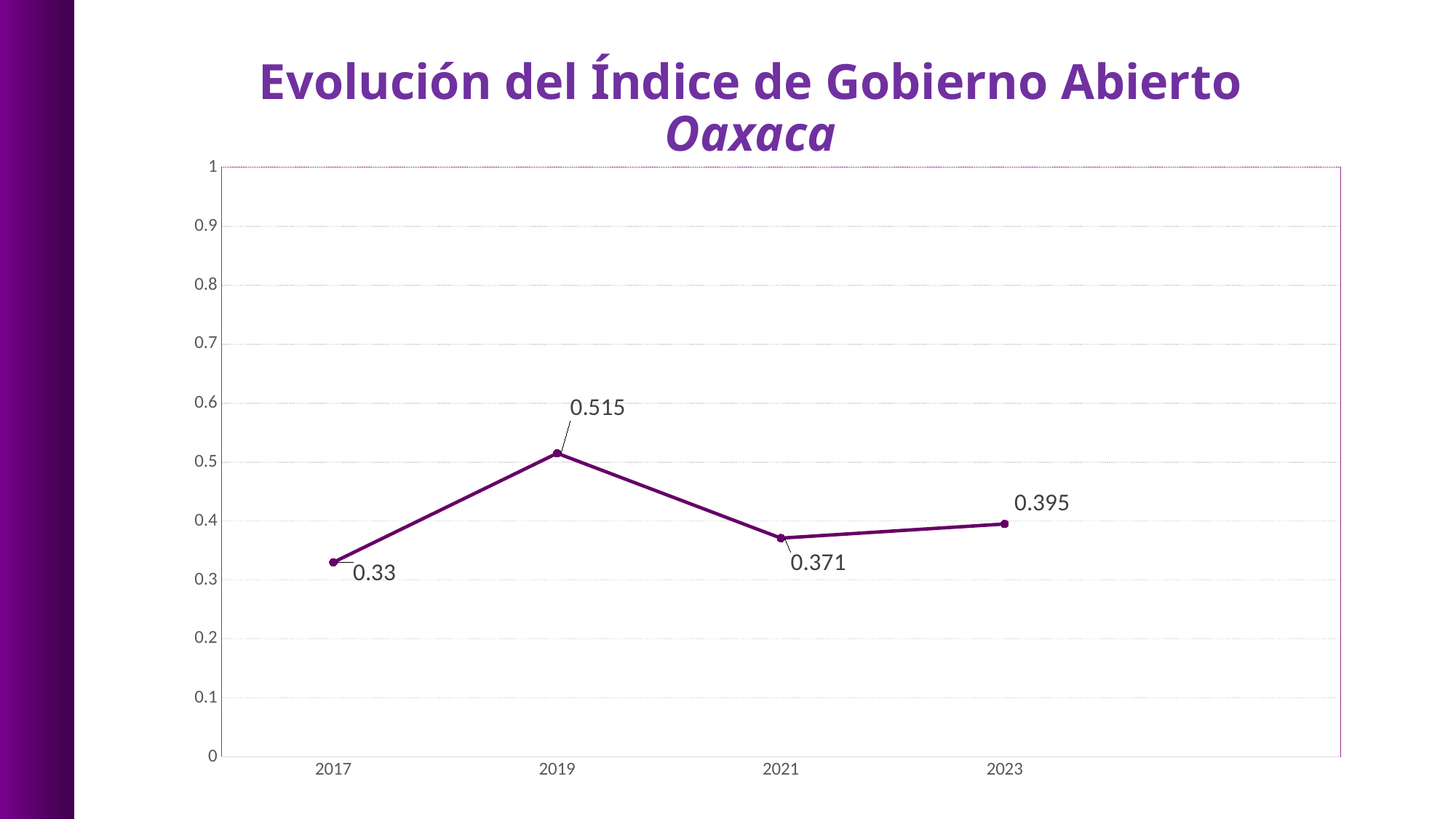
Is the value for 2019 greater or less than 0.5? greater What is the value of the index for 2021? 0.371 What is the value of the index for 2023? 0.395 Does the index value rise or fall from 2019 to 2021? Fall Which year has the lowest index value? 2017 What is the difference between the index values for 2019 and 2017? 0.185 How many years are plotted on the chart? 4 What kind of chart is shown on the slide? Line chart What is the value of the index for 2017? 0.33 Which year has a larger index value, 2021 or 2023? 2023 What is the value of the index for 2019? 0.515 Which year has the highest index value? 2019